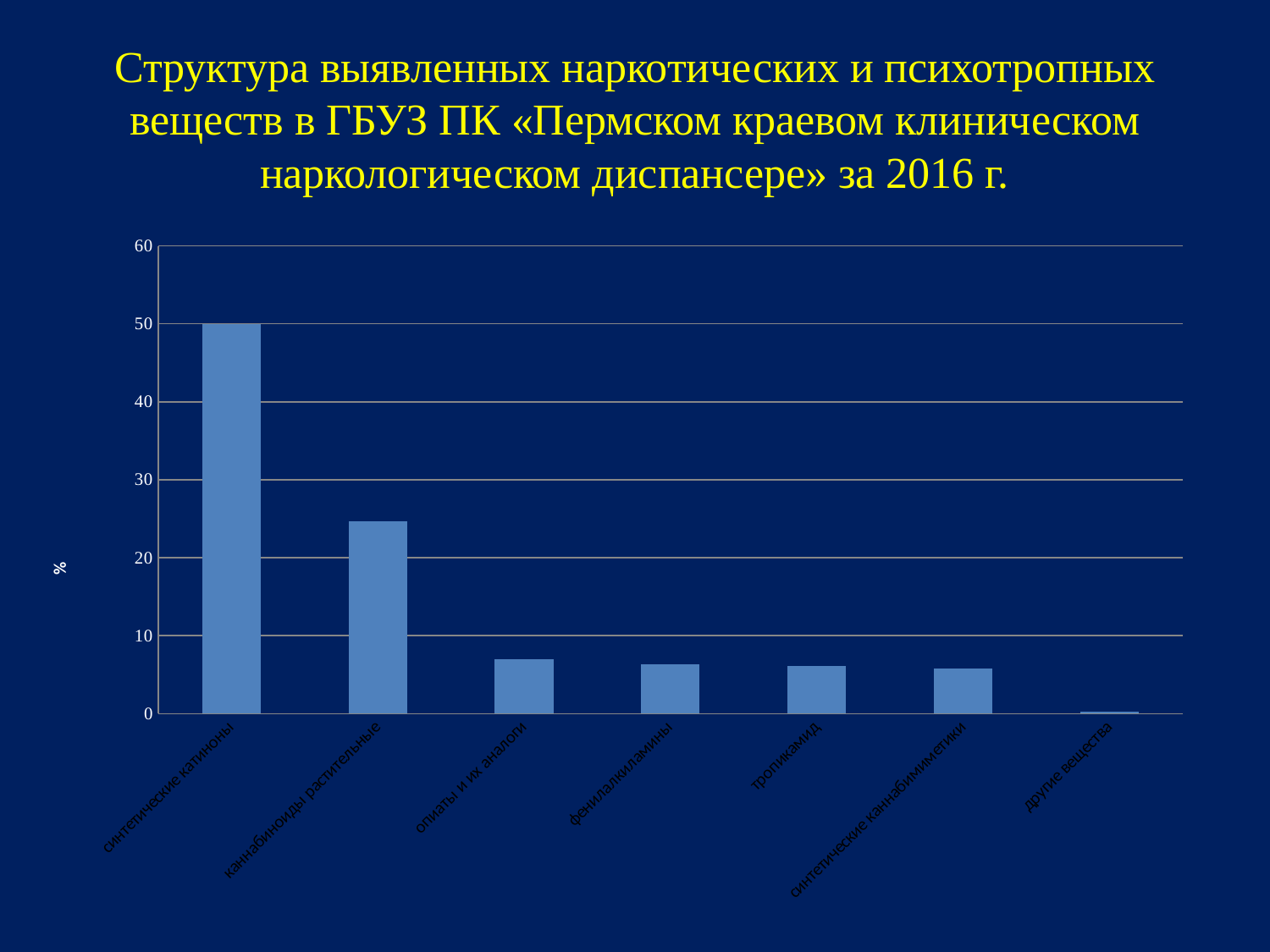
What is the label on the vertical axis of the chart? % Which is larger, the value for синтетические катиноны or the value for каннабиноиды растительные? синтетические катиноны Is the value for каннабиноиды растительные greater or less than 20? greater Do the values rise or fall from left to right along the x axis? fall How many categories are shown on the x axis of the chart? 7 Which category has the highest value in the chart? синтетические катиноны Is the value for каннабиноиды растительные greater or less than 30? less Is the value for опиаты и их аналоги greater or less than 10? less Which category has the lowest value in the chart? другие вещества What kind of chart is shown on the slide? bar chart Which is larger, the value for опиаты и их аналоги or the value for другие вещества? опиаты и их аналоги